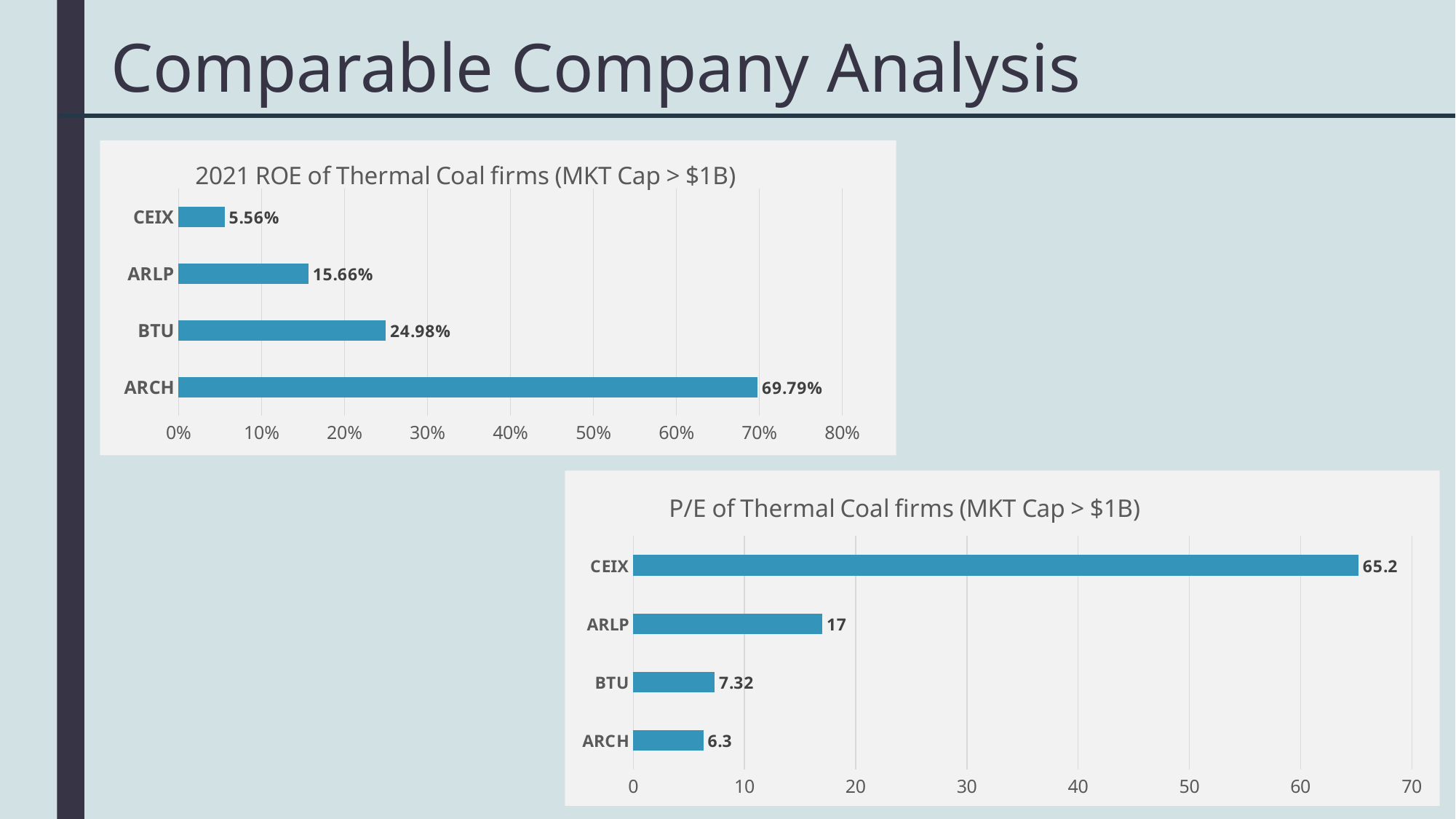
In the '2021 ROE of Thermal Coal firms (MKT Cap > $1B)' chart, which firm has the lowest ROE? CEIX What is the title of the chart in the upper left of the slide? 2021 ROE of Thermal Coal firms (MKT Cap > $1B) In the 'P/E of Thermal Coal firms (MKT Cap > $1B)' chart, what is the P/E for ARLP? 17 In the 'P/E of Thermal Coal firms (MKT Cap > $1B)' chart, which firm has the highest P/E? CEIX In the 'P/E of Thermal Coal firms (MKT Cap > $1B)' chart, which has a larger P/E, BTU or ARCH? BTU In the 'P/E of Thermal Coal firms (MKT Cap > $1B)' chart, what is the difference between the P/E of CEIX and ARLP? 48.2 In the '2021 ROE of Thermal Coal firms (MKT Cap > $1B)' chart, what is the difference between the ROE of ARCH and BTU? 44.81% In the '2021 ROE of Thermal Coal firms (MKT Cap > $1B)' chart, what is the ROE for BTU? 24.98% In the 'P/E of Thermal Coal firms (MKT Cap > $1B)' chart, which firm has the lowest P/E? ARCH In the '2021 ROE of Thermal Coal firms (MKT Cap > $1B)' chart, how many firms are shown? 4 In the '2021 ROE of Thermal Coal firms (MKT Cap > $1B)' chart, which firm has the highest ROE? ARCH What type of chart is the 'P/E of Thermal Coal firms (MKT Cap > $1B)' chart? Bar chart